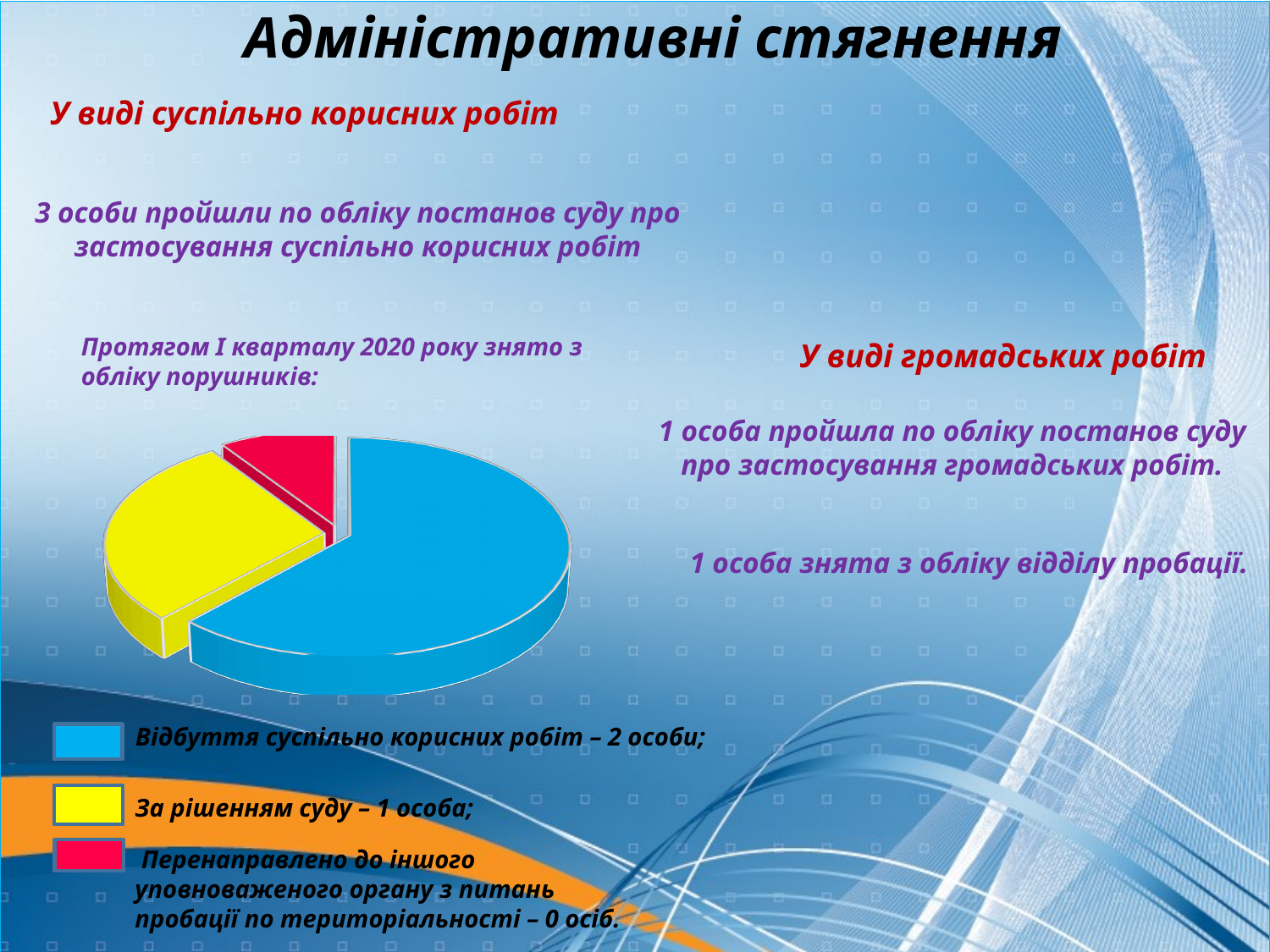
What is the difference between the number of people for "Відбуття суспільно корисних робіт" and for "За рішенням суду"? 1 According to the legend, how many people are in the category "За рішенням суду"? 1 особа What kind of chart is shown on the slide? pie chart Which category has the smallest slice of the pie chart? Перенаправлено до іншого уповноваженого органу з питань пробації по територіальності According to the legend, how many people were "Перенаправлено до іншого уповноваженого органу з питань пробації по територіальності"? 0 осіб What colour is the largest slice of the pie chart? blue According to the legend, how many people are in the category "Відбуття суспільно корисних робіт"? 2 особи Which category has the largest slice of the pie chart? Відбуття суспільно корисних робіт Which is larger: the slice for "Відбуття суспільно корисних робіт" or the slice for "За рішенням суду"? Відбуття суспільно корисних робіт How many slices does the pie chart have? 3 What colour is the slice for "За рішенням суду"? yellow